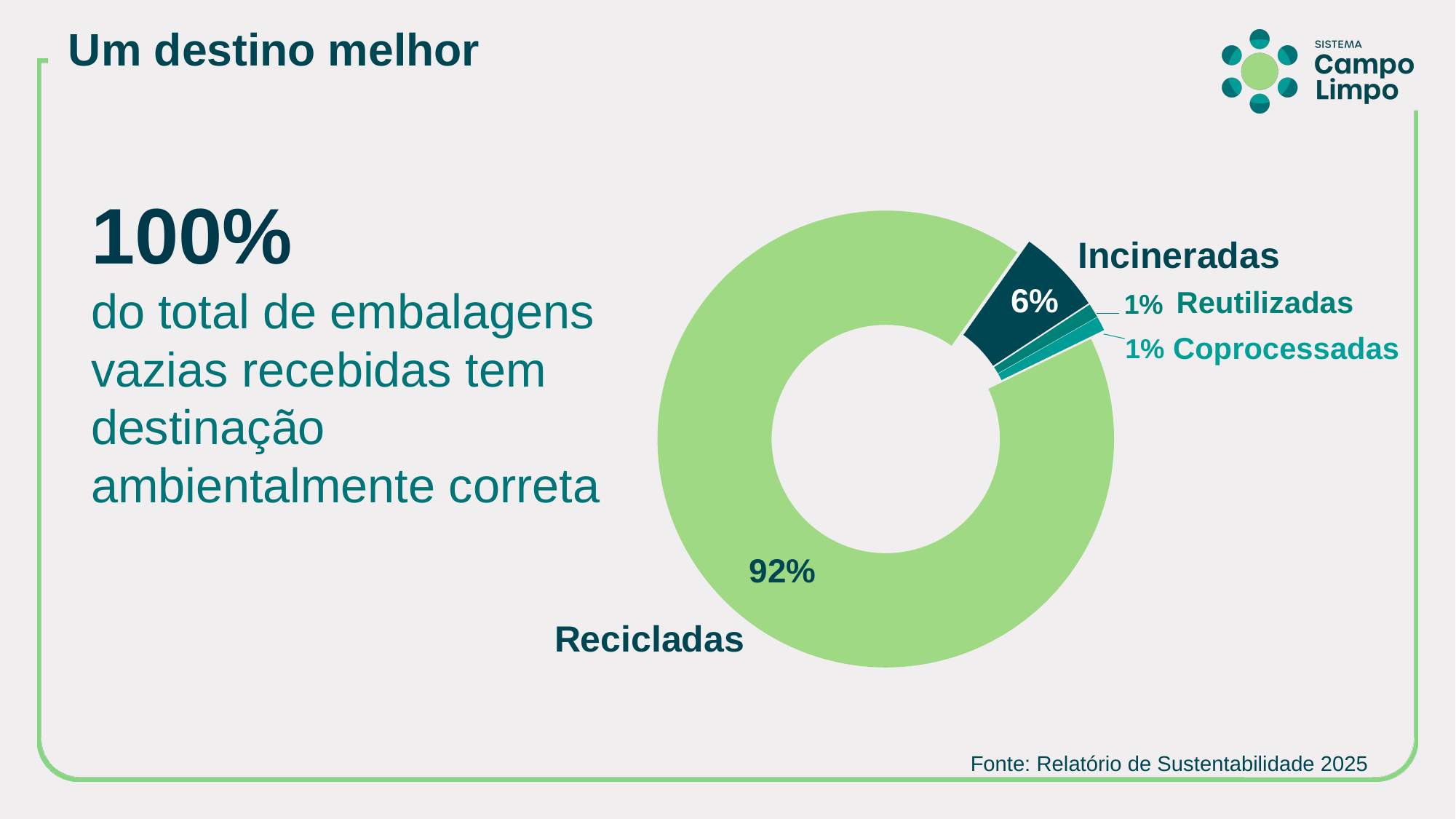
What colour is the Recicladas slice in the donut chart? Light green What share of the donut chart is labelled Coprocessadas? 1% Which category has the largest slice in the donut chart? Recicladas How many categories are shown in the donut chart? 4 What share of the donut chart is labelled Incineradas? 6% Which is larger in the donut chart, Incineradas or Reutilizadas? Incineradas What share of the donut chart is labelled Recicladas? 92% What is the combined share of Incineradas, Reutilizadas and Coprocessadas? 8% What share of the donut chart is labelled Reutilizadas? 1% What is the title of the slide containing the donut chart? Um destino melhor What kind of chart is shown on the slide? Donut (pie) chart What is the difference in percentage points between Recicladas and Incineradas? 86